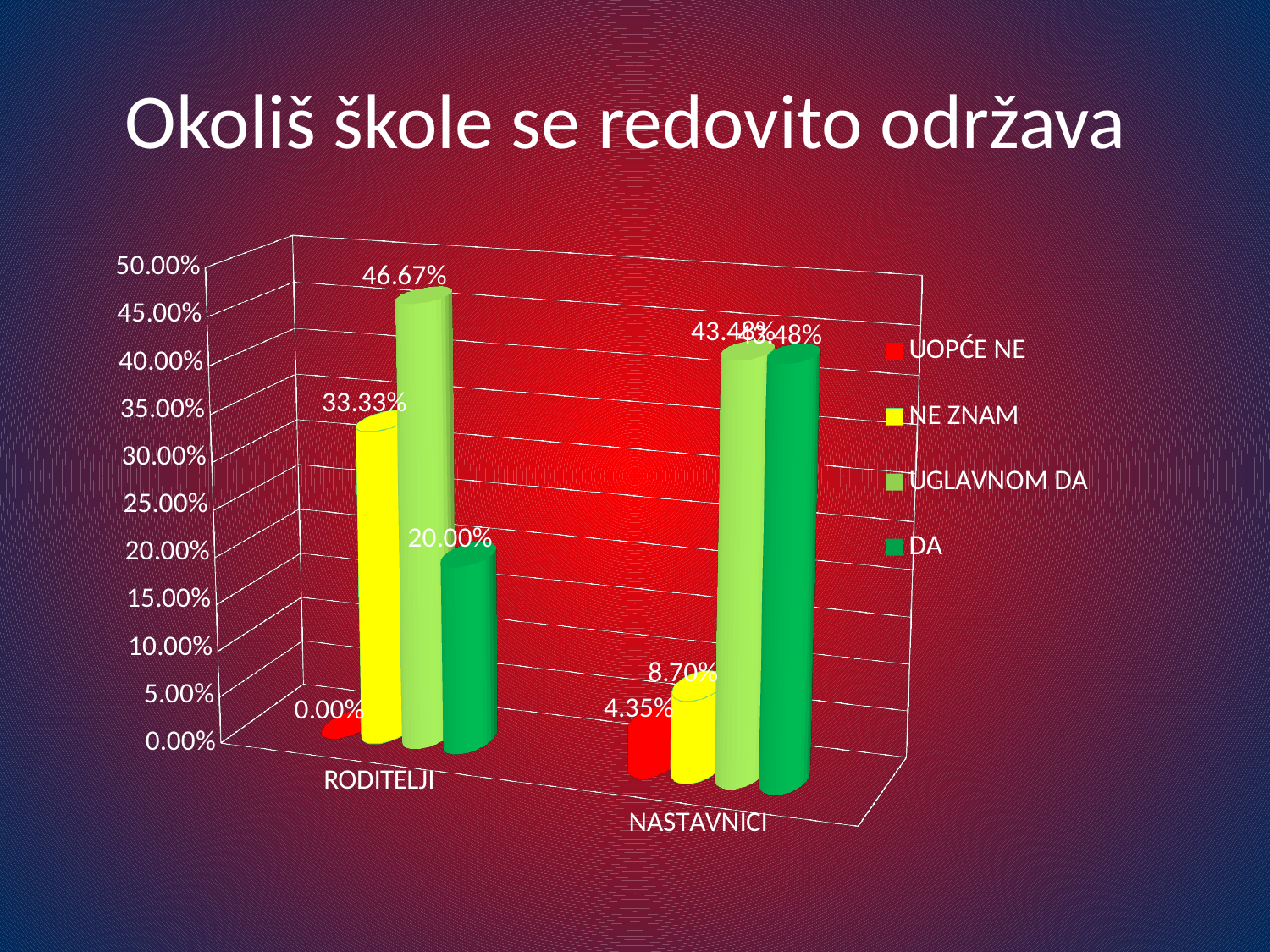
What is the title of the chart? Okoliš škole se redovito održava How many series does the legend list? 4 What is the value for NE ZNAM in the RODITELJI category? 33.33% Which series has the highest value in the RODITELJI category? UGLAVNOM DA What is the value for DA in the RODITELJI category? 20.00% What is the value for UOPĆE NE in the NASTAVNICI category? 4.35% What is the value for UGLAVNOM DA in the RODITELJI category? 46.67% What is the value for NE ZNAM in the NASTAVNICI category? 8.70% Which is larger: the DA value for RODITELJI or the DA value for NASTAVNICI? NASTAVNICI Which series has the lowest value in the NASTAVNICI category? UOPĆE NE What type of chart is shown on the slide? Bar chart What is the difference between the UGLAVNOM DA and DA values in the RODITELJI category? 26.67%